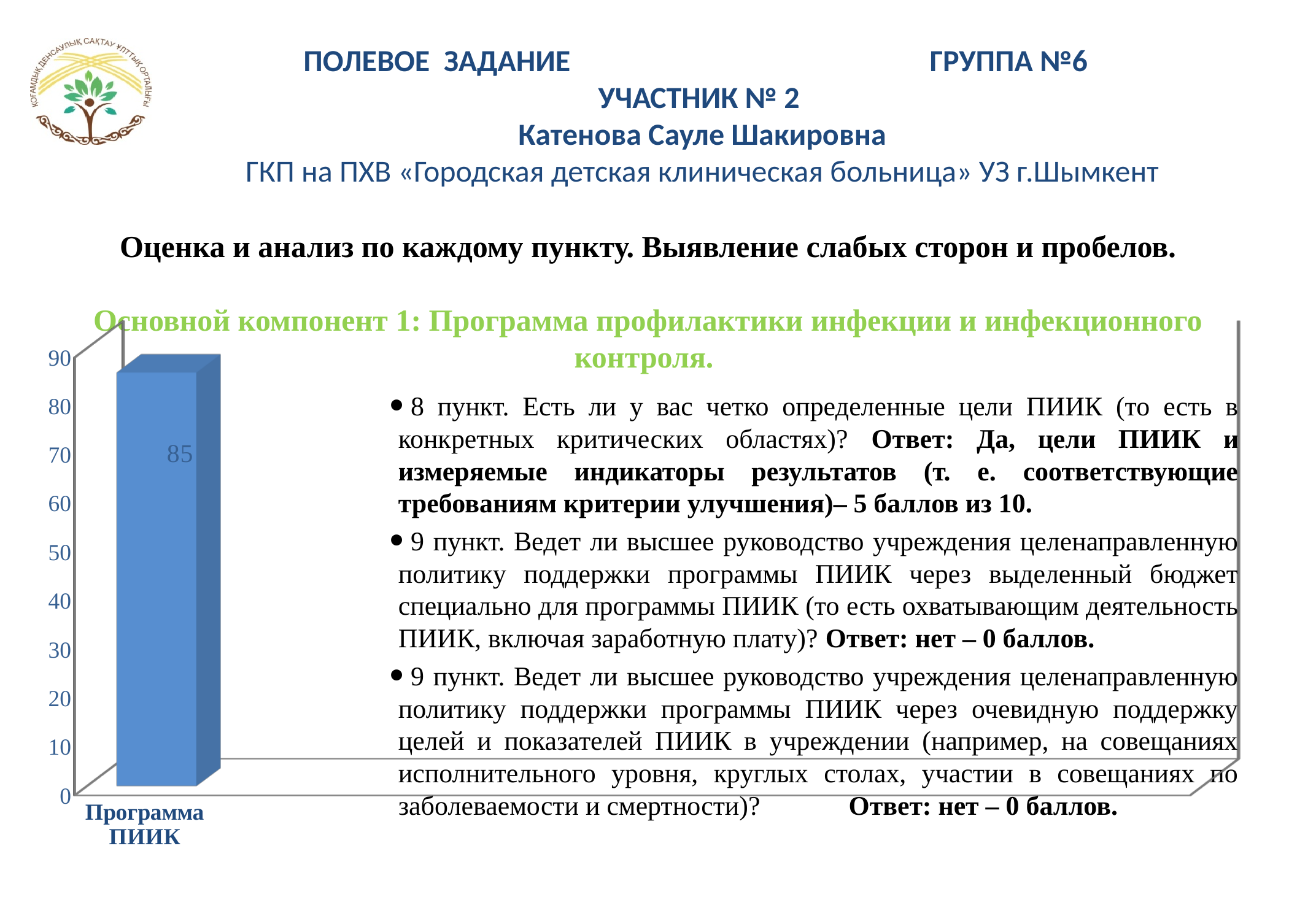
What is the highest value shown on the chart's vertical axis? 90 What is the value shown for Программа ПИИК in the bar chart? 85 What is the label of the category on the x axis of the chart? Программа ПИИК Is the value for Программа ПИИК greater or less than 90? less How many bars does the chart contain? 1 What kind of chart is shown on the slide? bar chart Is the value for Программа ПИИК greater or less than 80? greater